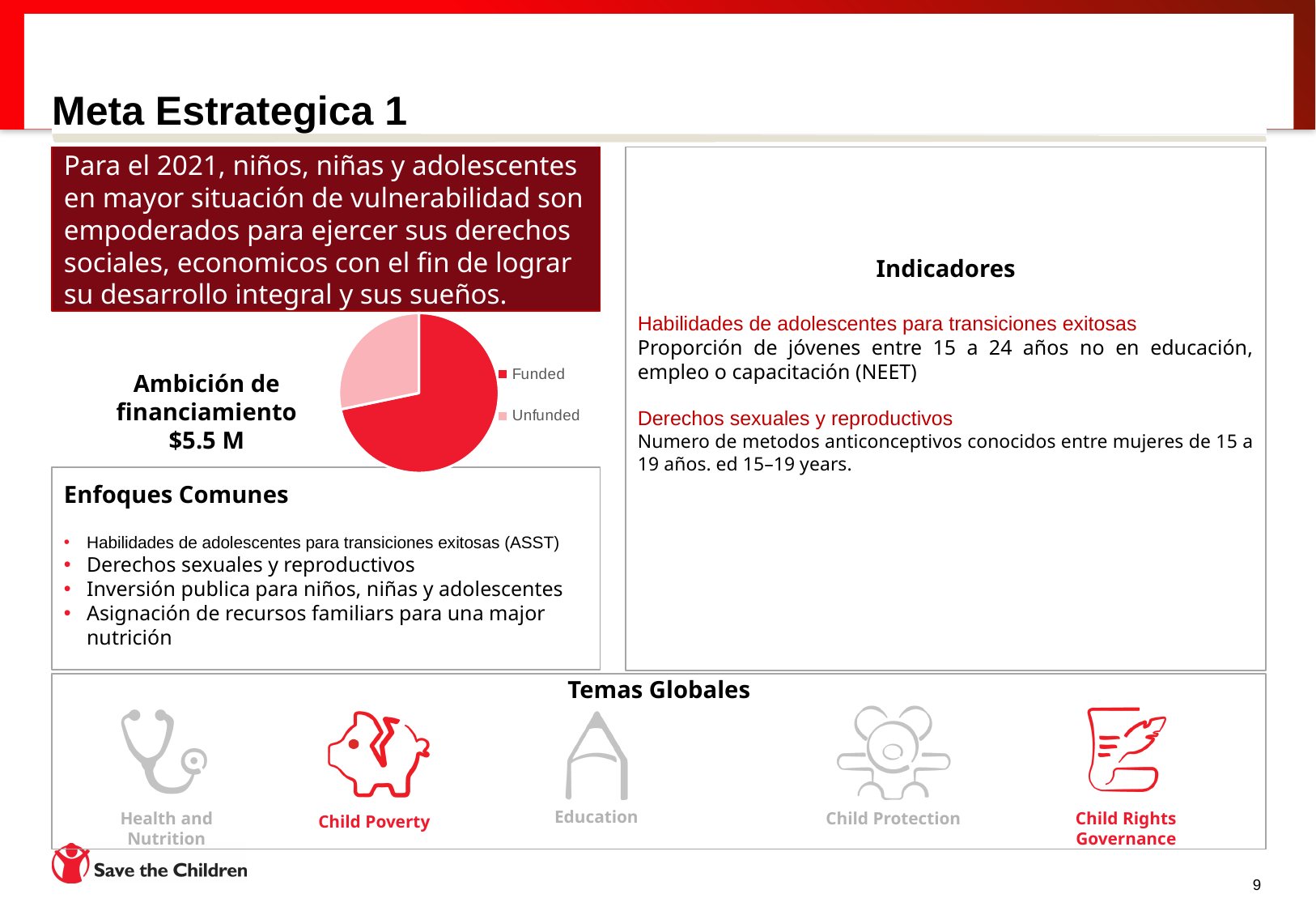
What kind of chart is shown on the slide? pie chart Which slice of the pie chart is the smallest? Unfunded What colour is the Unfunded slice in the pie chart? light pink In the pie chart, which is larger, Funded or Unfunded? Funded How many slices does the pie chart have? 2 Does the Funded slice take up more or less than half of the pie chart? more What are the two legend entries of the pie chart? Funded, Unfunded How many entries does the pie chart's legend list? 2 Which slice of the pie chart is the largest? Funded